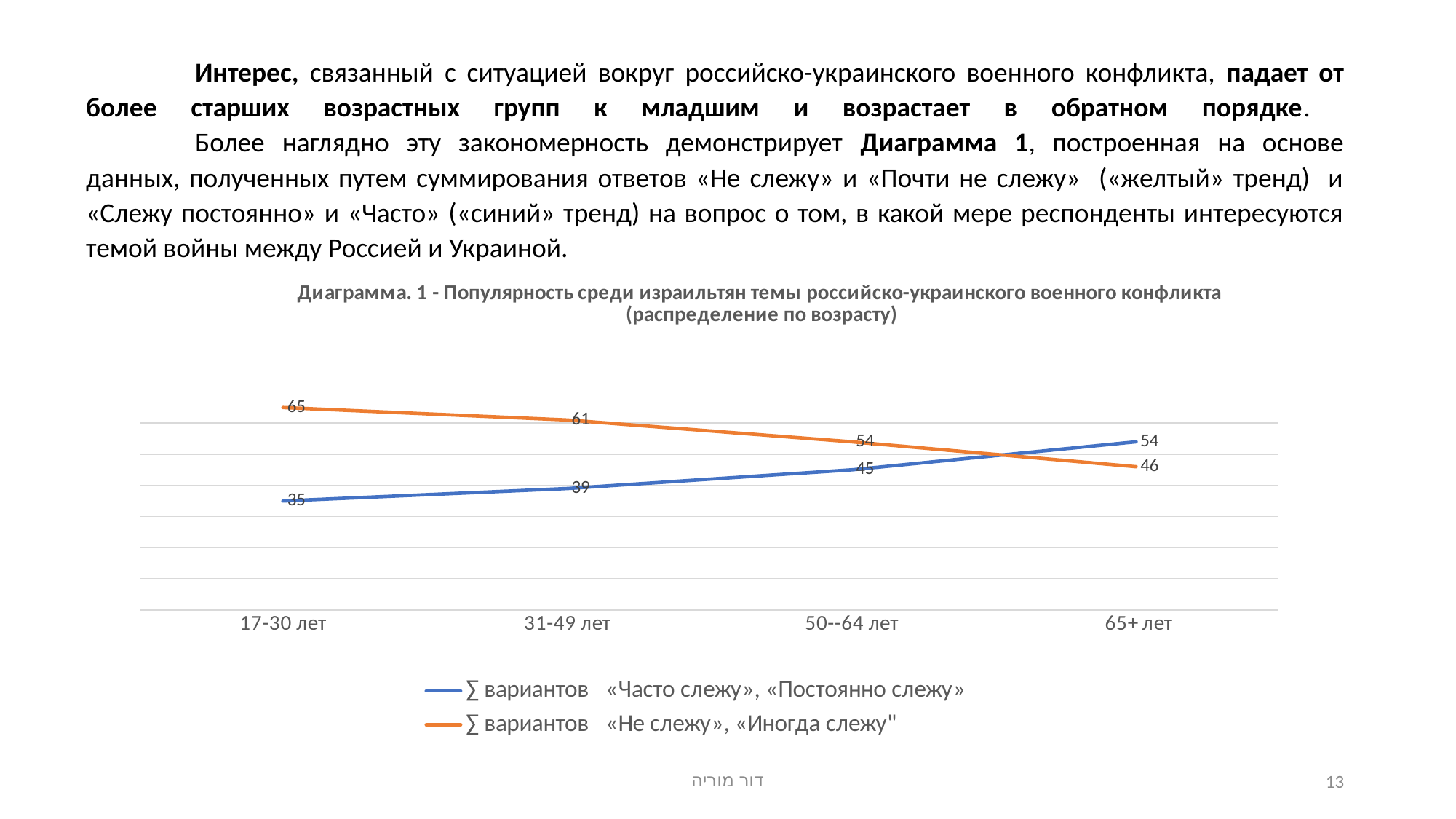
What is the difference between the orange and blue series values for the 17-30 лет group? 30 What is the value of the orange series (∑ вариантов «Не слежу», «Иногда слежу») for the 31-49 лет group? 61 For the 50--64 лет group, which series has the larger value, blue or orange? orange For which age group is the blue series (∑ вариантов «Часто слежу», «Постоянно слежу») lowest? 17-30 лет What type of chart is shown on the slide? line chart For which age group is the orange series (∑ вариантов «Не слежу», «Иногда слежу») highest? 17-30 лет What is the value of the blue series for the 65+ лет group? 54 How many age groups are shown on the x axis? 4 Does the blue series rise or fall from the 17-30 лет group to the 65+ лет group? rise What is the value of the blue series (∑ вариантов «Часто слежу», «Постоянно слежу») for the 17-30 лет group? 35 What is the value of the orange series for the 65+ лет group? 46 How many series does the legend list? 2